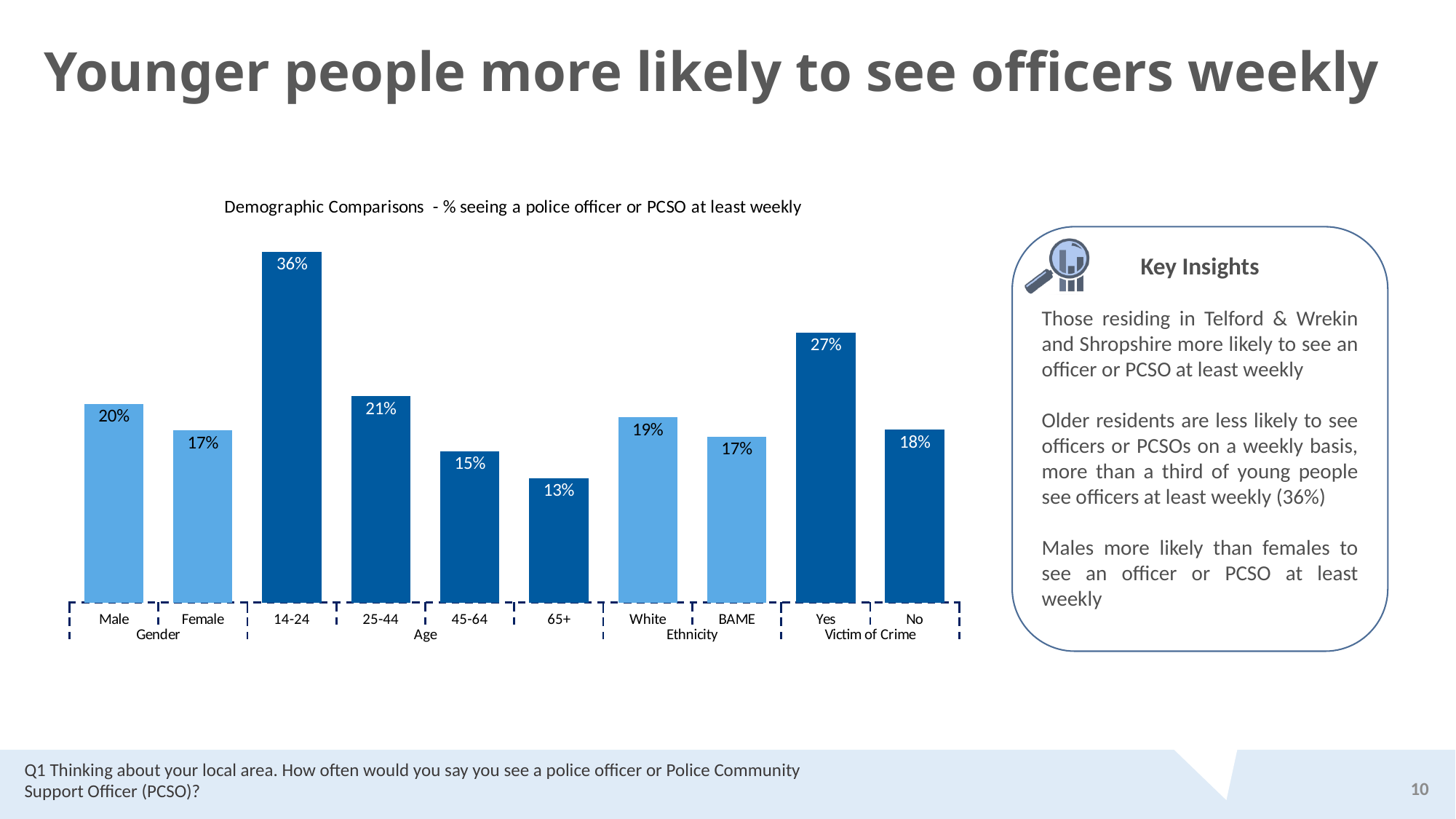
What is the title of the chart? Demographic Comparisons - % seeing a police officer or PCSO at least weekly How many bars are plotted in the chart? 10 Which category has the lowest percentage seeing an officer or PCSO at least weekly? 65+ What percentage of the 14-24 age group see a police officer or PCSO at least weekly? 36% Do the values rise or fall across the age groups from 14-24 to 65+? Fall What is the value shown for victims of crime (Yes)? 27% Which category has the highest percentage seeing an officer or PCSO at least weekly? 14-24 What is the difference in percentage points between Male and Female? 3 What is the difference in percentage points between the 14-24 and 65+ age groups? 23 Which is larger, the value for White or the value for BAME? White What kind of chart is shown on the slide? Bar chart What is the value shown for Female? 17%